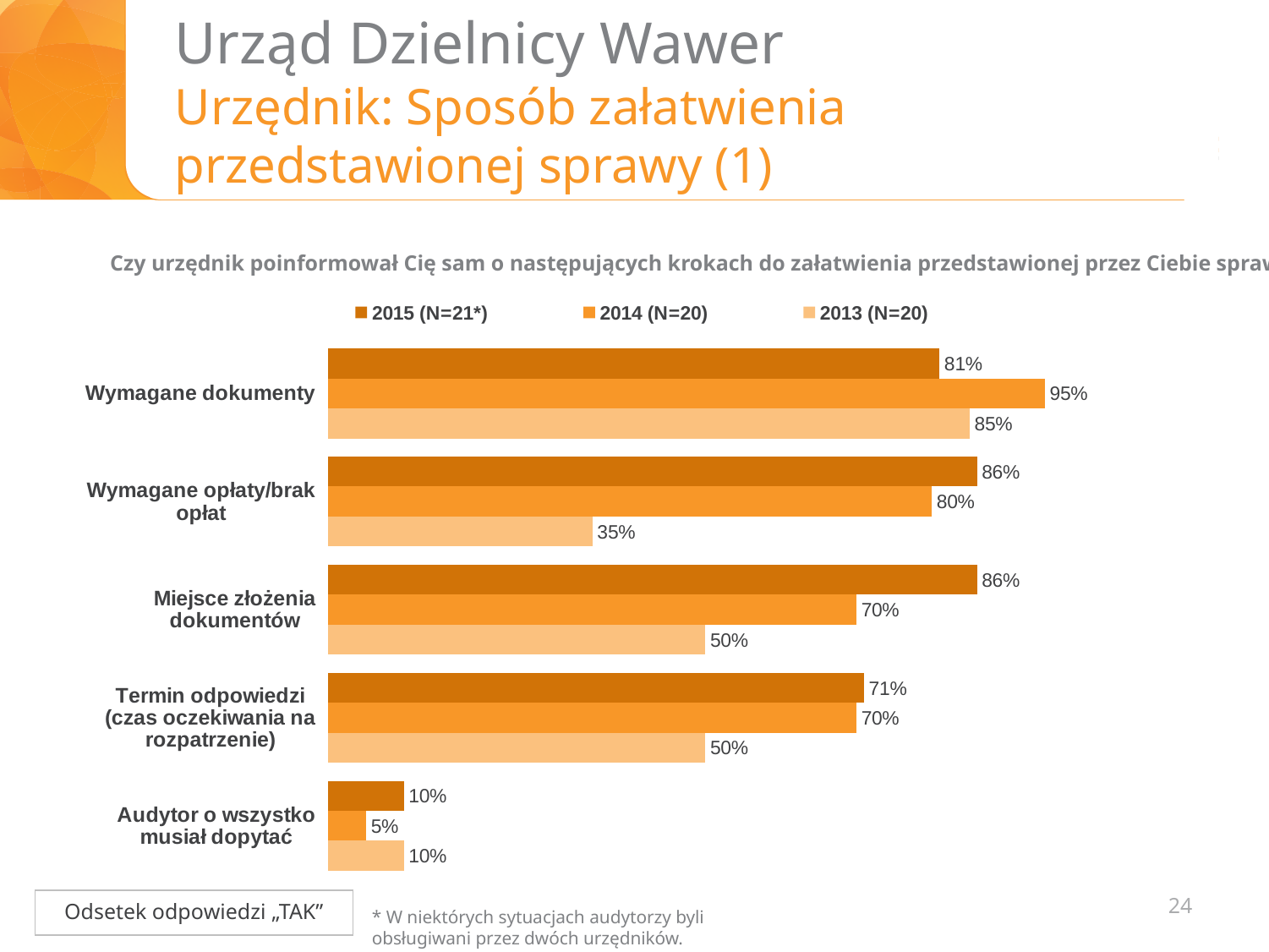
What is the value for "Audytor o wszystko musiał dopytać" in the 2014 (N=20) series? 5% What is the difference between the 2015 and 2013 values for "Miejsce złożenia dokumentów"? 36% What is the difference between the 2014 and 2013 values for "Wymagane opłaty/brak opłat"? 45% What does the box at the bottom left of the chart say the values represent? Odsetek odpowiedzi „TAK” Which category has the lowest value in the 2015 (N=21*) series? Audytor o wszystko musiał dopytać Which is larger for "Wymagane dokumenty": the 2015 (N=21*) value or the 2013 (N=20) value? 2013 (N=20) How many categories are shown on the chart? 5 What is the value for "Wymagane dokumenty" in the 2014 (N=20) series? 95% What is the value for "Wymagane opłaty/brak opłat" in the 2013 (N=20) series? 35% How many series does the legend list? 3 Which category has the highest value in the 2014 (N=20) series? Wymagane dokumenty What kind of chart is shown on the slide? bar chart